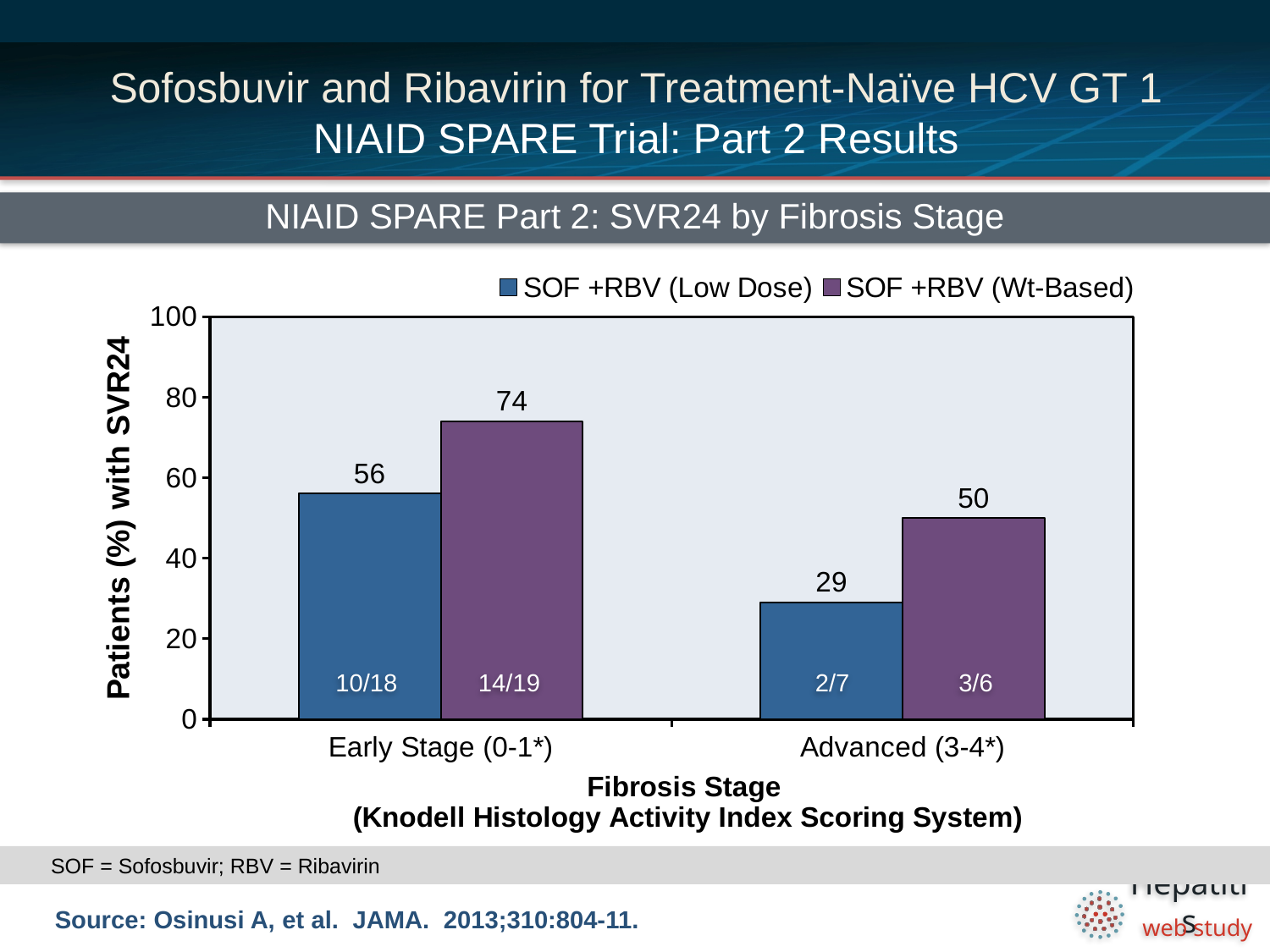
What is the SVR24 rate for SOF +RBV (Wt-Based) in the Advanced (3-4*) group? 50 What kind of chart is shown on the slide? Bar chart How many fibrosis stage categories are shown on the x axis? 2 How many series does the legend list? 2 Which bar has the lowest SVR24 value on the chart? SOF +RBV (Low Dose), Advanced (3-4*) Which is larger: the SOF +RBV (Low Dose) value for Early Stage (0-1*) or the SOF +RBV (Wt-Based) value for Advanced (3-4*)? SOF +RBV (Low Dose) for Early Stage (0-1*) What is the difference between the SOF +RBV (Wt-Based) and SOF +RBV (Low Dose) values in the Early Stage (0-1*) group? 18 What is the SVR24 rate for SOF +RBV (Low Dose) in the Early Stage (0-1*) group? 56 What fraction of patients is shown inside the SOF +RBV (Low Dose) bar for Advanced (3-4*)? 2/7 What fraction of patients is shown inside the SOF +RBV (Wt-Based) bar for Early Stage (0-1*)? 14/19 Which bar has the highest SVR24 value on the chart? SOF +RBV (Wt-Based), Early Stage (0-1*) What is the difference between the SOF +RBV (Wt-Based) and SOF +RBV (Low Dose) values in the Advanced (3-4*) group? 21